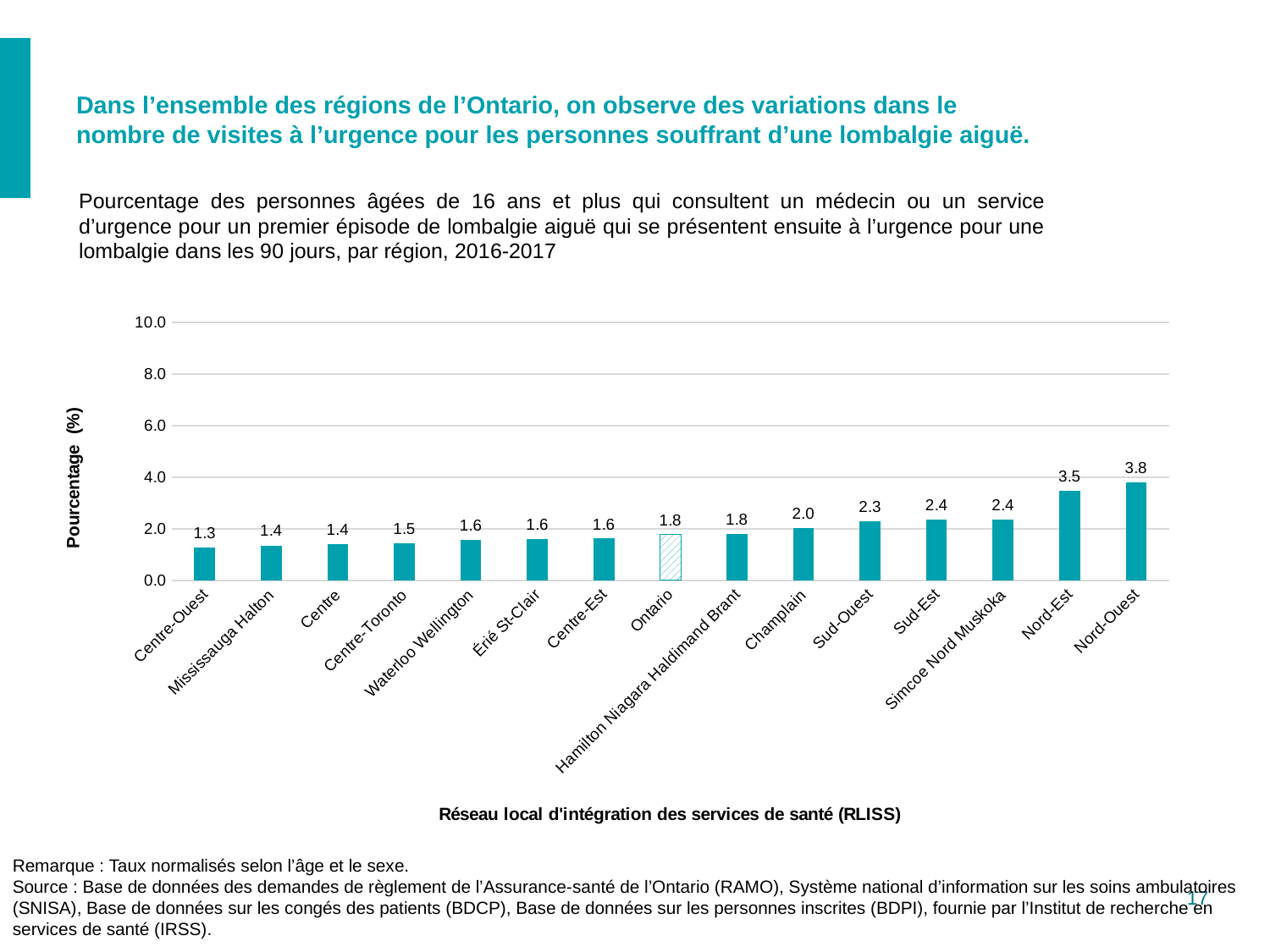
What is the difference between the values for Nord-Est and Centre-Ouest? 2.2 What is the value for Nord-Ouest? 3.8 How many bars are shown in the chart? 15 Which region has the highest value? Nord-Ouest What kind of chart is shown on the slide? Bar chart Which region has the lowest value? Centre-Ouest What is the value for Champlain? 2.0 Which is larger, the value for Sud-Ouest or the value for Hamilton Niagara Haldimand Brant? Sud-Ouest Is the value for Nord-Est greater or less than 4.0? less What is the value for Centre-Toronto? 1.5 What is the value for Ontario? 1.8 What is the label of the vertical axis? Pourcentage (%)